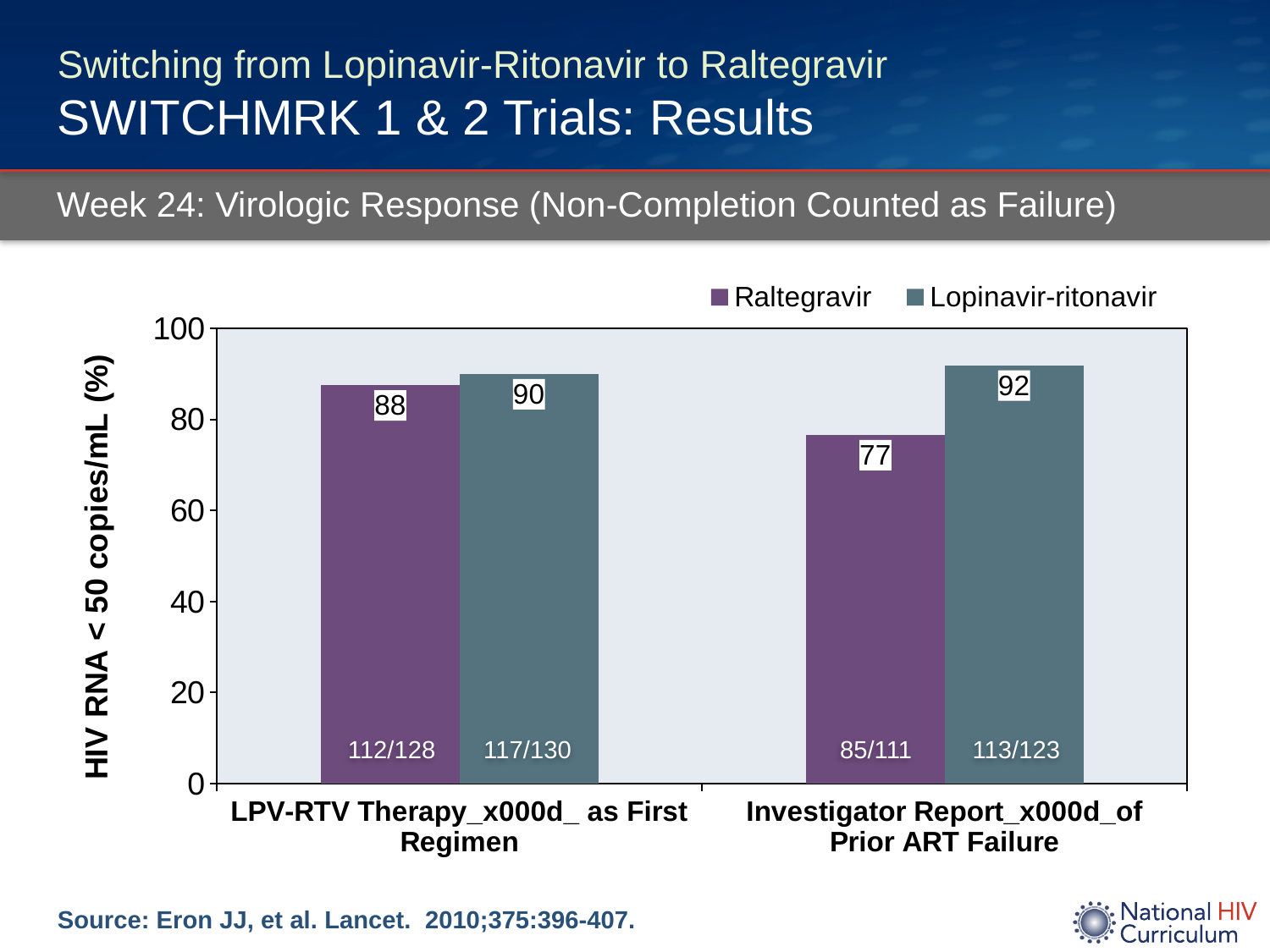
What is the difference between the Lopinavir-ritonavir and Raltegravir values in the Investigator Report of Prior ART Failure group? 15 What is the value for Lopinavir-ritonavir in the LPV-RTV Therapy as First Regimen group? 90 How many series does the legend list? 2 In the Investigator Report of Prior ART Failure group, which series has the larger value, Raltegravir or Lopinavir-ritonavir? Lopinavir-ritonavir What is the y-axis label of the chart? HIV RNA < 50 copies/mL (%) Which bar has the highest value on the chart? Lopinavir-ritonavir, Investigator Report of Prior ART Failure Which bar has the lowest value on the chart? Raltegravir, Investigator Report of Prior ART Failure What is the value for Raltegravir in the LPV-RTV Therapy as First Regimen group? 88 What is the value for Lopinavir-ritonavir in the Investigator Report of Prior ART Failure group? 92 What kind of chart is shown on the slide? Bar chart What fraction is printed on the Raltegravir bar in the Investigator Report of Prior ART Failure group? 85/111 What is the value for Raltegravir in the Investigator Report of Prior ART Failure group? 77